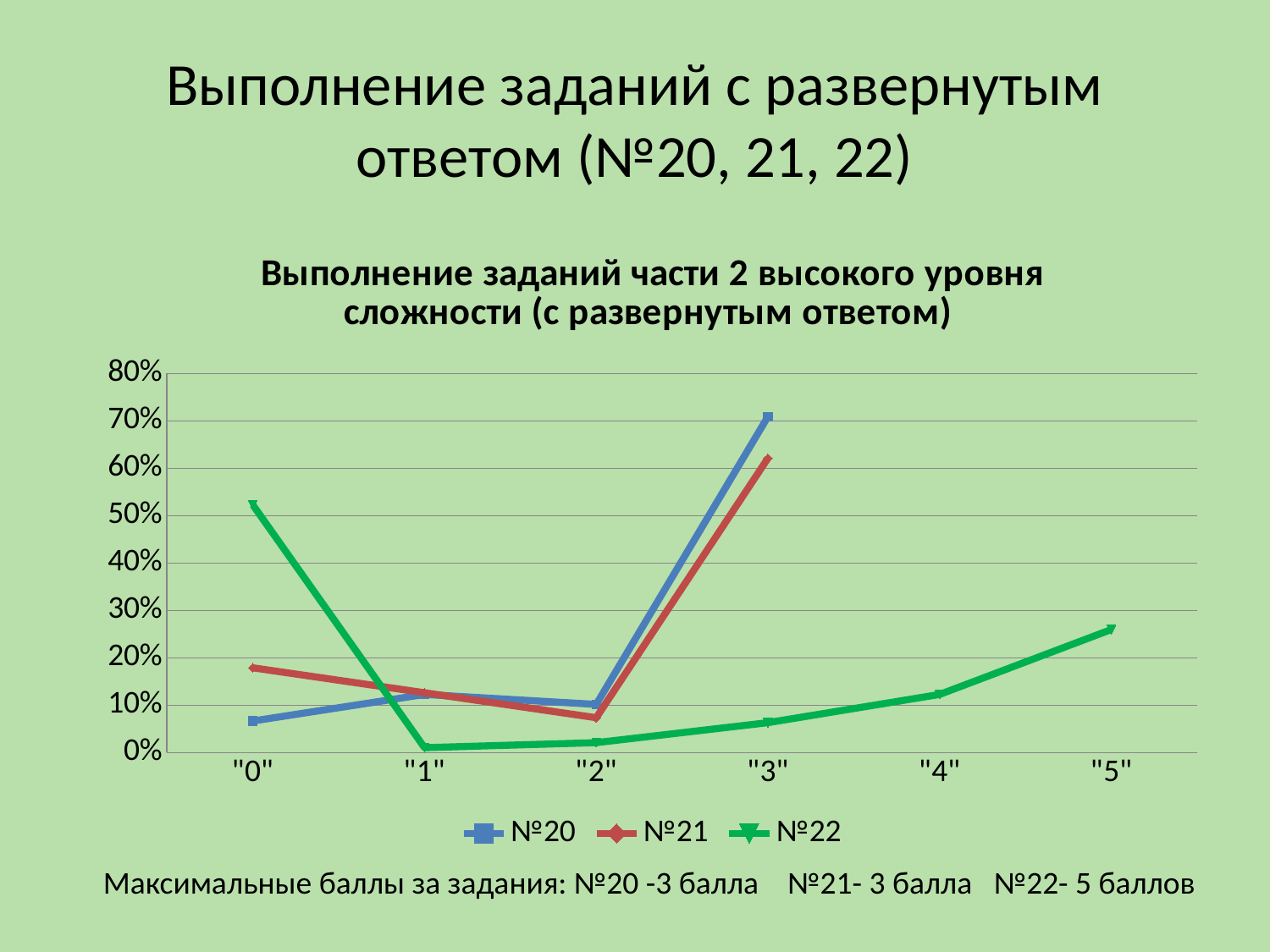
Is the value for №21 at category "2" greater or less than 20%? less At category "0", which series has the higher value, №22 or №21? №22 For which category does the №22 series reach its highest value? "0" How many series does the legend list? 3 Is the value for №22 at category "0" greater or less than 40%? greater For which category does the №20 series reach its highest value? "3" Does the №22 series rise or fall from category "1" to category "5"? rise For which category does the №22 series have its lowest value? "1" How many categories are shown on the x axis? 6 Is the value for №20 at category "3" greater or less than 60%? greater At category "3", which series has the higher value, №20 or №21? №20 What kind of chart is shown on the slide? line chart